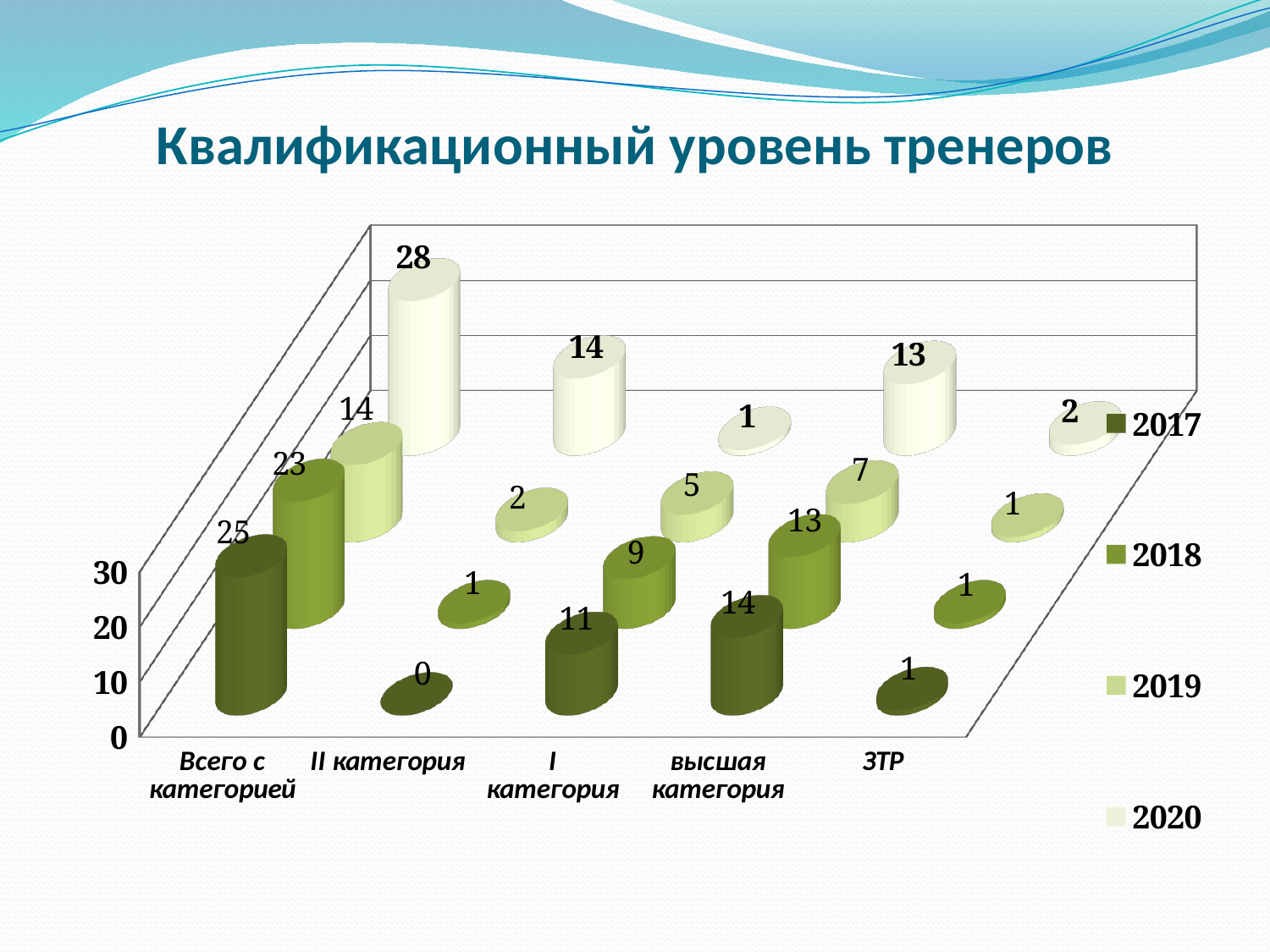
What is the value for 2018 in the 'I категория' category? 9 Which series has the lowest value in the 'II категория' category? 2017 Which is larger in the 'I категория' category: the value for 2017 or the value for 2019? 2017 What kind of chart is shown on the slide? Bar chart What is the value for 2019 in the 'высшая категория' category? 7 What is the value for 2020 in the 'II категория' category? 14 How many series does the legend list? 4 Which series has the highest value in the 'Всего с категорией' category? 2020 How many categories are shown on the x axis? 5 What is the value for 2017 in the 'Всего с категорией' category? 25 What is the title of the chart? Квалификационный уровень тренеров What is the difference between the 2020 and 2017 values in the 'Всего с категорией' category? 3